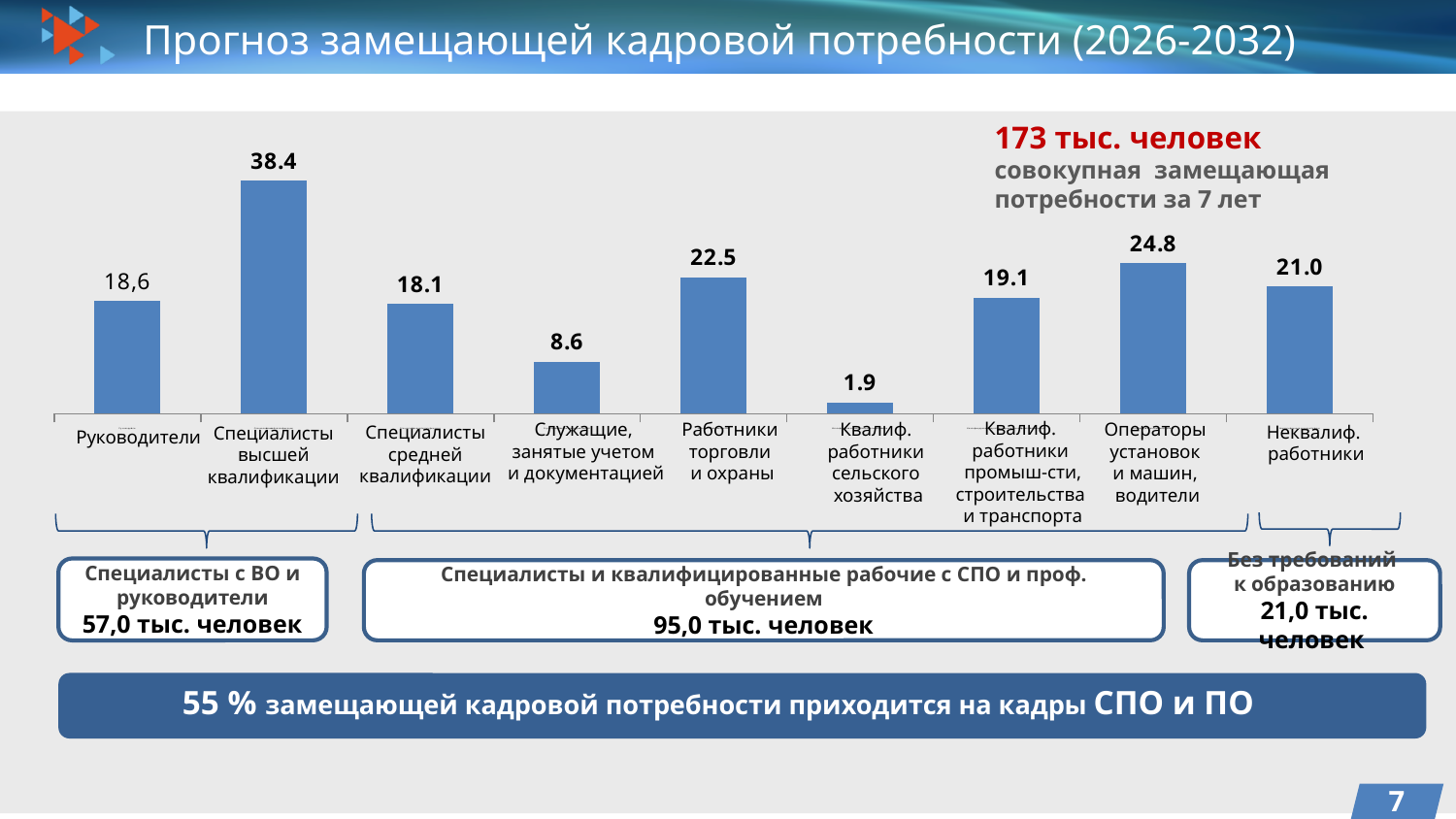
Какая категория имеет наименьшее значение на диаграмме? Квалиф. работники сельского хозяйства Какое значение показано для категории «Руководители»? 18,6 Что больше: значение для «Работники торговли и охраны» или для «Квалиф. работники промыш-сти, строительства и транспорта»? Работники торговли и охраны На сколько значение для «Операторы установок и машин, водители» больше значения для «Работники торговли и охраны»? 2.3 Какое значение показано для категории «Служащие, занятые учетом и документацией»? 8.6 Какое значение показано для категории «Операторы установок и машин, водители»? 24.8 Сколько категорий показано на диаграмме? 9 Какая категория имеет наибольшее значение на диаграмме? Специалисты высшей квалификации Какого типа эта диаграмма? Столбчатая (bar chart) Какое значение показано для категории «Специалисты высшей квалификации»? 38.4 На сколько значение для «Специалисты высшей квалификации» больше значения для «Специалисты средней квалификации»? 20.3 Какое значение показано для категории «Квалиф. работники сельского хозяйства»? 1.9